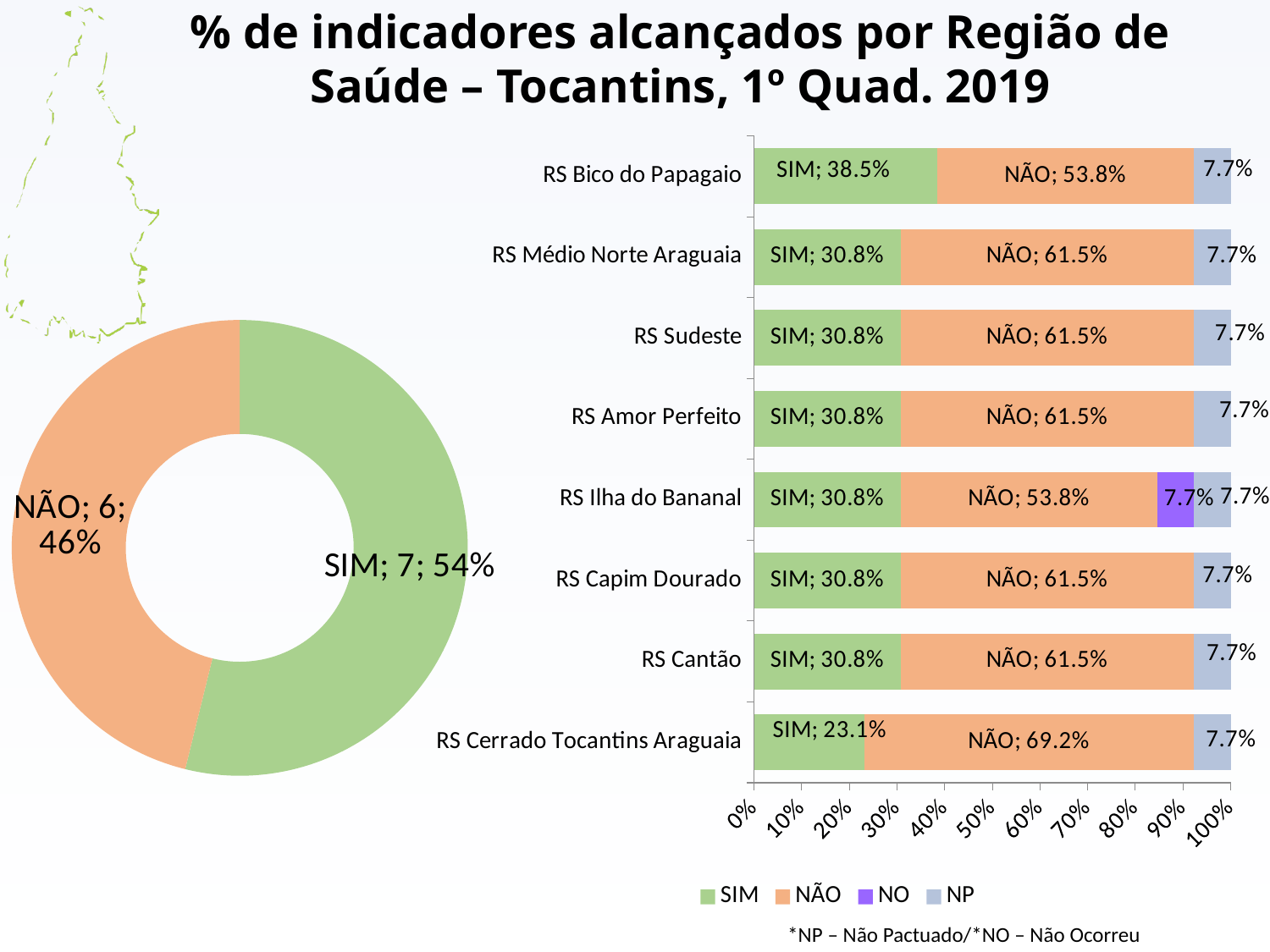
In the stacked bar chart on the right, what is the SIM value for RS Bico do Papagaio? 38.5% In the doughnut chart on the left, what share of the total does SIM represent? 54% In the stacked bar chart on the right, which region has the highest SIM value? RS Bico do Papagaio In the stacked bar chart on the right, how many series does the legend list? 4 In the stacked bar chart on the right, what is the difference between the NÃO value for RS Cerrado Tocantins Araguaia and the NÃO value for RS Bico do Papagaio? 15.4% In the stacked bar chart on the right, how many regions are shown? 8 In the stacked bar chart on the right, which region has the lowest SIM value? RS Cerrado Tocantins Araguaia In the stacked bar chart on the right, which region is the only one with a NO (Não Ocorreu) segment? RS Ilha do Bananal In the stacked bar chart on the right, what is the NÃO value for RS Ilha do Bananal? 53.8% In the stacked bar chart on the right, what is the NÃO value for RS Cerrado Tocantins Araguaia? 69.2% In the stacked bar chart on the right, which is larger: the SIM value for RS Bico do Papagaio or the SIM value for RS Cantão? RS Bico do Papagaio In the doughnut chart on the left, what is the count for NÃO? 6